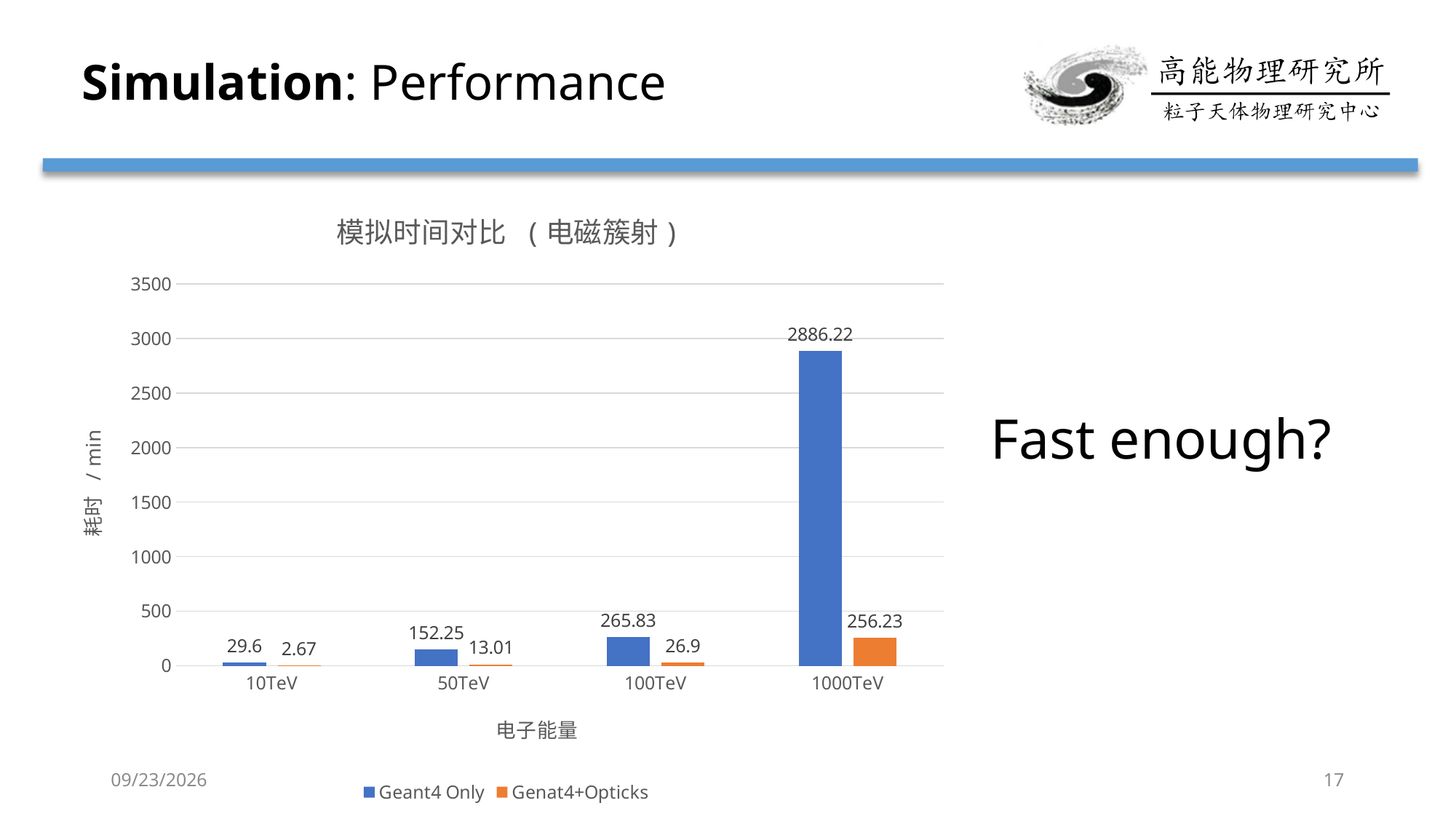
What is the difference between the Geant4 Only and Genat4+Opticks values at 1000TeV? 2629.99 What is the difference between the Geant4 Only and Genat4+Opticks values at 100TeV? 238.93 What is the Geant4 Only value for 1000TeV? 2886.22 Which energy category has the lowest Genat4+Opticks value? 10TeV What is the Genat4+Opticks value for 10TeV? 2.67 What is the Geant4 Only value for 100TeV? 265.83 How many energy categories are shown on the x axis? 4 Which is larger at 50TeV: the Geant4 Only value or the Genat4+Opticks value? Geant4 Only Which energy category has the highest Geant4 Only value? 1000TeV How many series does the legend list? 2 What kind of chart is shown on the slide? Bar chart What is the Genat4+Opticks value for 50TeV? 13.01